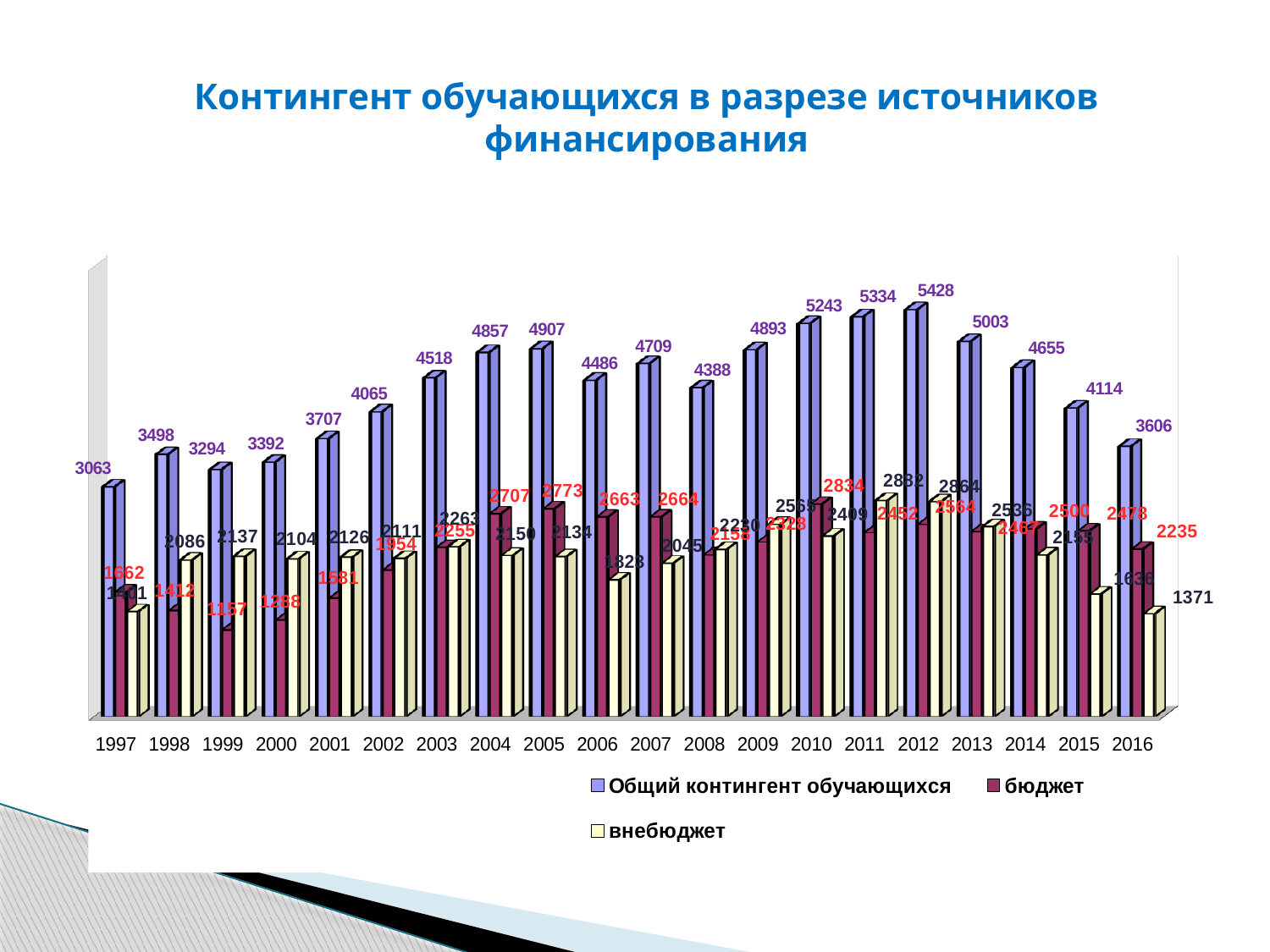
What is the внебюджет value for 2016? 1371 What kind of chart is shown on the slide? bar chart Which is larger in 2006: бюджет or внебюджет? бюджет What is the difference between Общий контингент обучающихся in 2012 and in 2016? 1822 In which year is Общий контингент обучающихся lowest? 1997 What is the value of Общий контингент обучающихся for 2012? 5428 What is the title of the chart? Контингент обучающихся в разрезе источников финансирования Does Общий контингент обучающихся rise or fall from 2012 to 2016? fall In which year is Общий контингент обучающихся highest? 2012 How many years are shown on the x axis? 20 What is the бюджет value for 1999? 1157 How many series does the legend list? 3